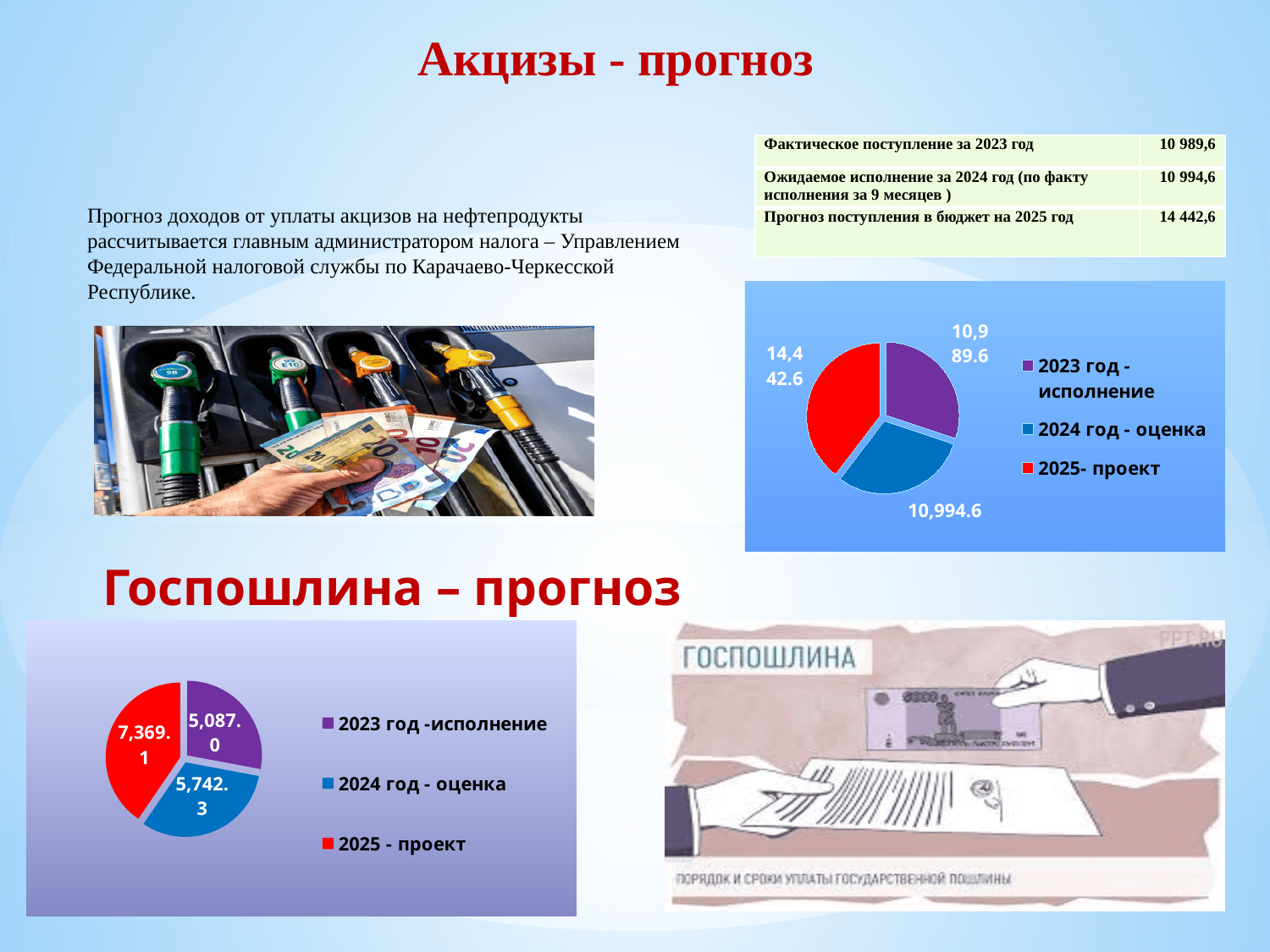
In the bottom-left pie chart, what is the value for 2023 год -исполнение? 5,087.0 In the top-right pie chart, what is the value for 2024 год - оценка? 10,994.6 In the bottom-left pie chart, what colour is the slice for 2025 - проект? red In the bottom-left pie chart, which category has the smallest slice? 2023 год -исполнение In the top-right pie chart, what is the value for 2025- проект? 14,442.6 In the top-right pie chart, what is the difference between the 2025- проект value and the 2023 год - исполнение value? 3,453.0 In the top-right pie chart, which category has the largest slice? 2025- проект What kind of chart is shown in the top-right of the slide? pie chart In the bottom-left pie chart, what is the difference between the 2024 год - оценка value and the 2023 год -исполнение value? 655.3 In the bottom-left pie chart, which is larger: 2024 год - оценка or 2025 - проект? 2025 - проект In the top-right pie chart, how many series does the legend list? 3 In the bottom-left pie chart, what is the value for 2025 - проект? 7,369.1